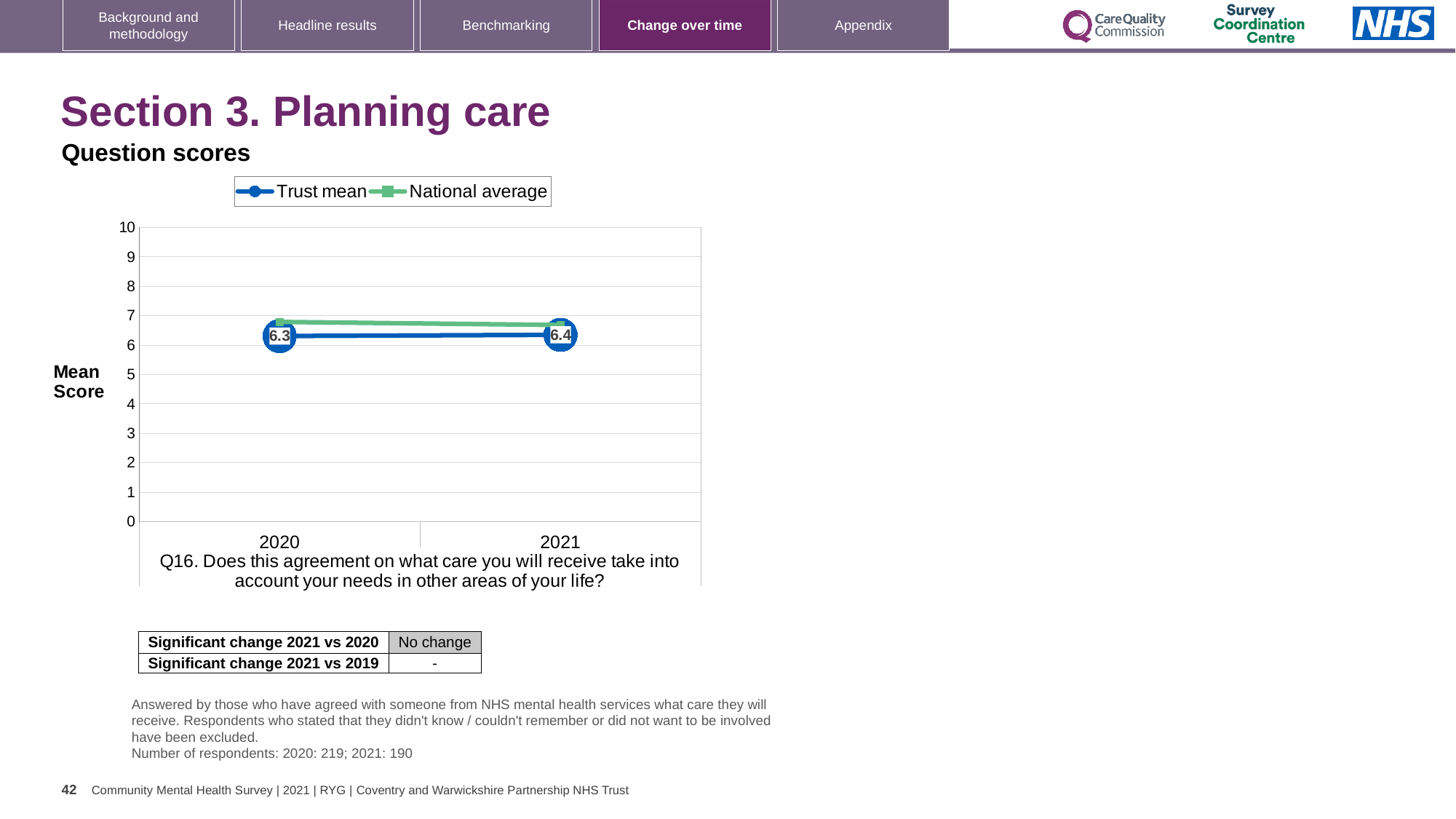
In 2020, which series is higher: Trust mean or National average? National average How many years are shown on the x axis of the chart? 2 What is the Trust mean score for 2020? 6.3 What is the Trust mean score for 2021? 6.4 Is the National average value for 2021 greater or less than 8? less By how much did the Trust mean change from 2020 to 2021? 0.1 How many series does the legend list? 2 What is the label on the y axis of the chart? Mean Score What kind of chart is shown on the slide? Line chart Does the Trust mean rise or fall from 2020 to 2021? Rise Which year has the higher Trust mean, 2020 or 2021? 2021 Is the National average value for 2020 greater or less than 5? greater